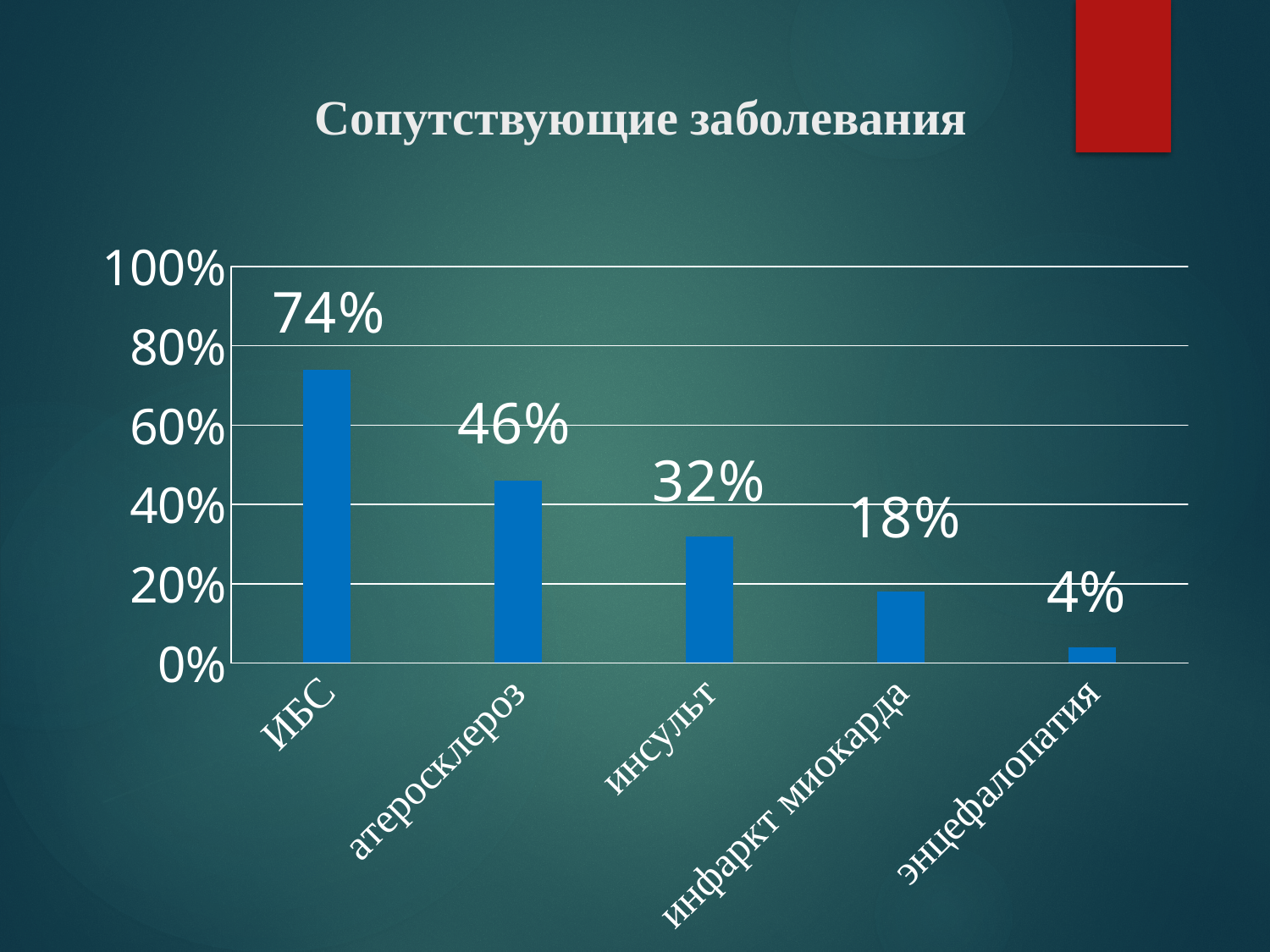
What is the value for атеросклероз? 46% What is the value for ИБС? 74% Is the value for атеросклероз greater or less than 40%? greater Which is larger, the value for инсульт or the value for инфаркт миокарда? инсульт What is the difference between the values for ИБС and атеросклероз? 28% Which category has the lowest value? энцефалопатия What is the value for инфаркт миокарда? 18% What kind of chart is shown on the slide? bar chart How many categories are shown on the chart? 5 What is the title of the slide? Сопутствующие заболевания Which category has the highest value? ИБС What is the difference between the values for инсульт and энцефалопатия? 28%